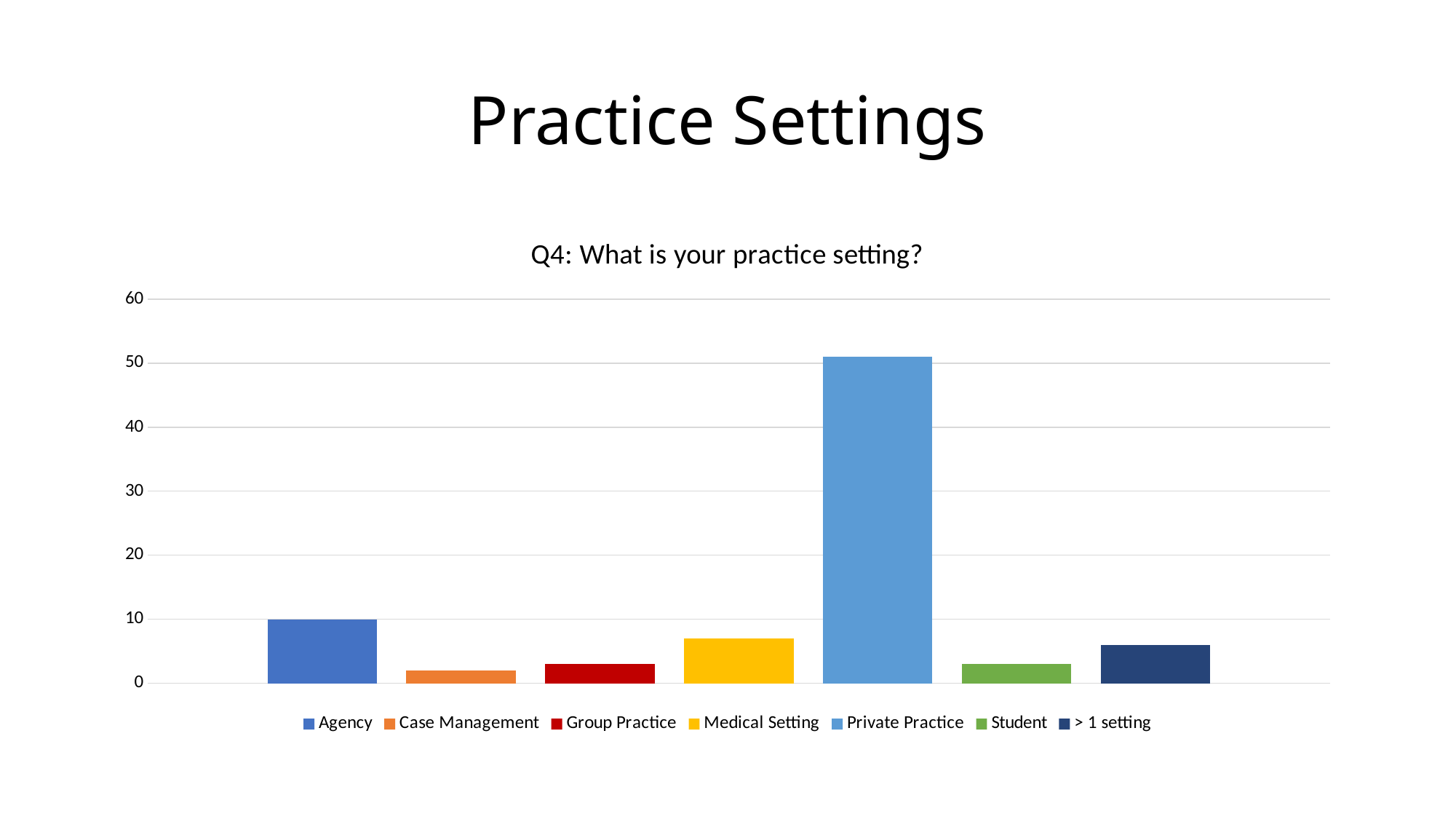
What type of chart is shown on the slide? bar chart Is the value for Medical Setting greater or less than 10? less Which is larger, the value for Agency or the value for Medical Setting? Agency What is the title of the chart? Q4: What is your practice setting? How many entries does the legend list? 7 Which is larger, the value for Private Practice or the value for Student? Private Practice Which practice setting has the highest value? Private Practice How many practice setting categories are plotted in the chart? 7 What is the value for Agency? 10 Is the value for Private Practice greater or less than 40? greater Is the value for > 1 setting greater or less than 10? less Which practice setting has the lowest value? Case Management